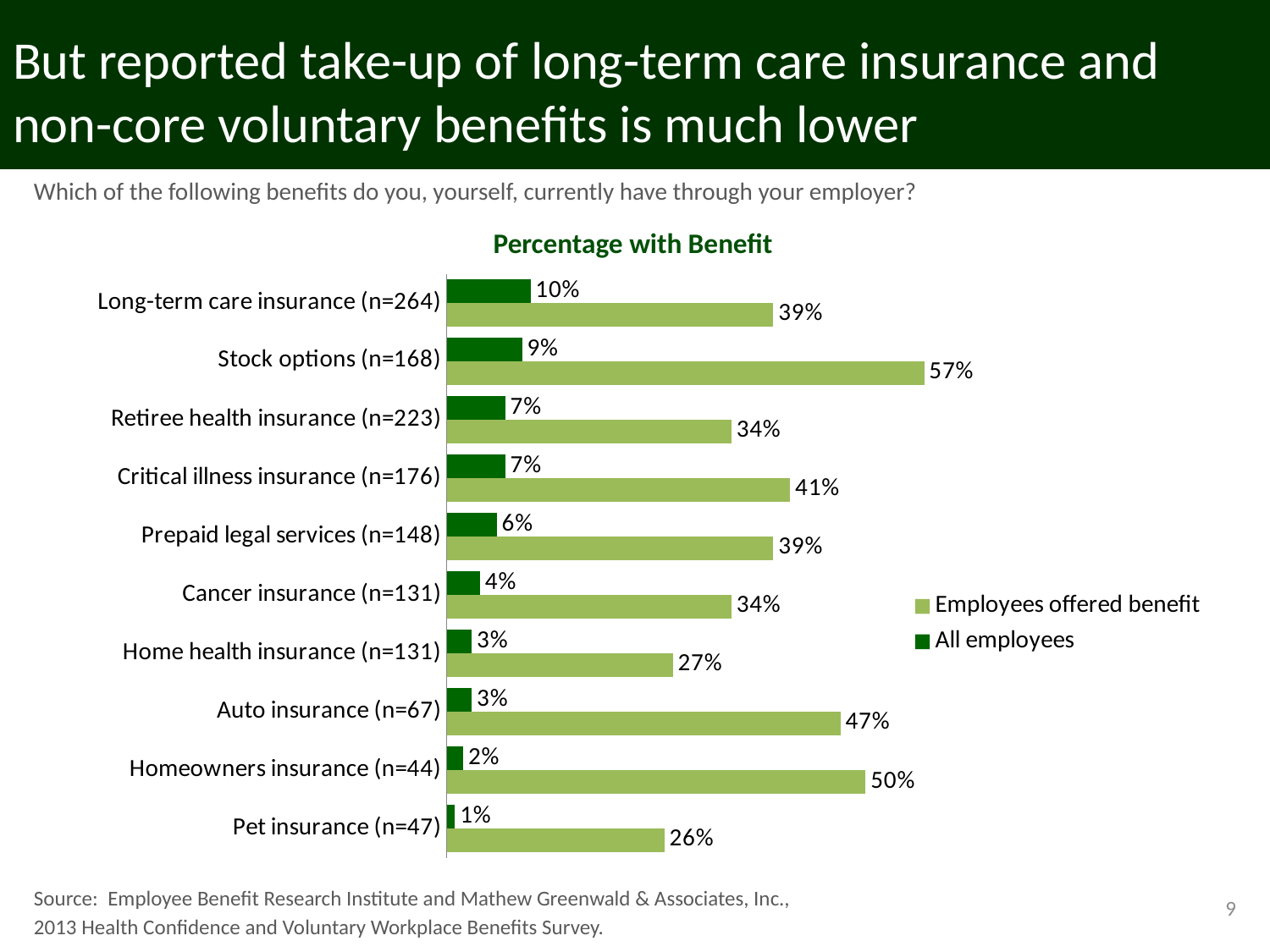
Which series is shown in dark green? All employees What is the difference between the Employees offered benefit and All employees values for Homeowners insurance? 48% How many benefit categories are shown in the chart? 10 Which benefit has the highest value for Employees offered benefit? Stock options (n=168) What is the value for All employees for Long-term care insurance? 10% What percentage of employees offered the benefit have stock options? 57% What is the value for Employees offered benefit for Pet insurance? 26% What kind of chart is shown on the slide? Bar chart What is the title of the chart? Percentage with Benefit Which is larger: the Employees offered benefit value for Auto insurance or for Critical illness insurance? Auto insurance How many series does the legend list? 2 Which benefit has the lowest value for All employees? Pet insurance (n=47)